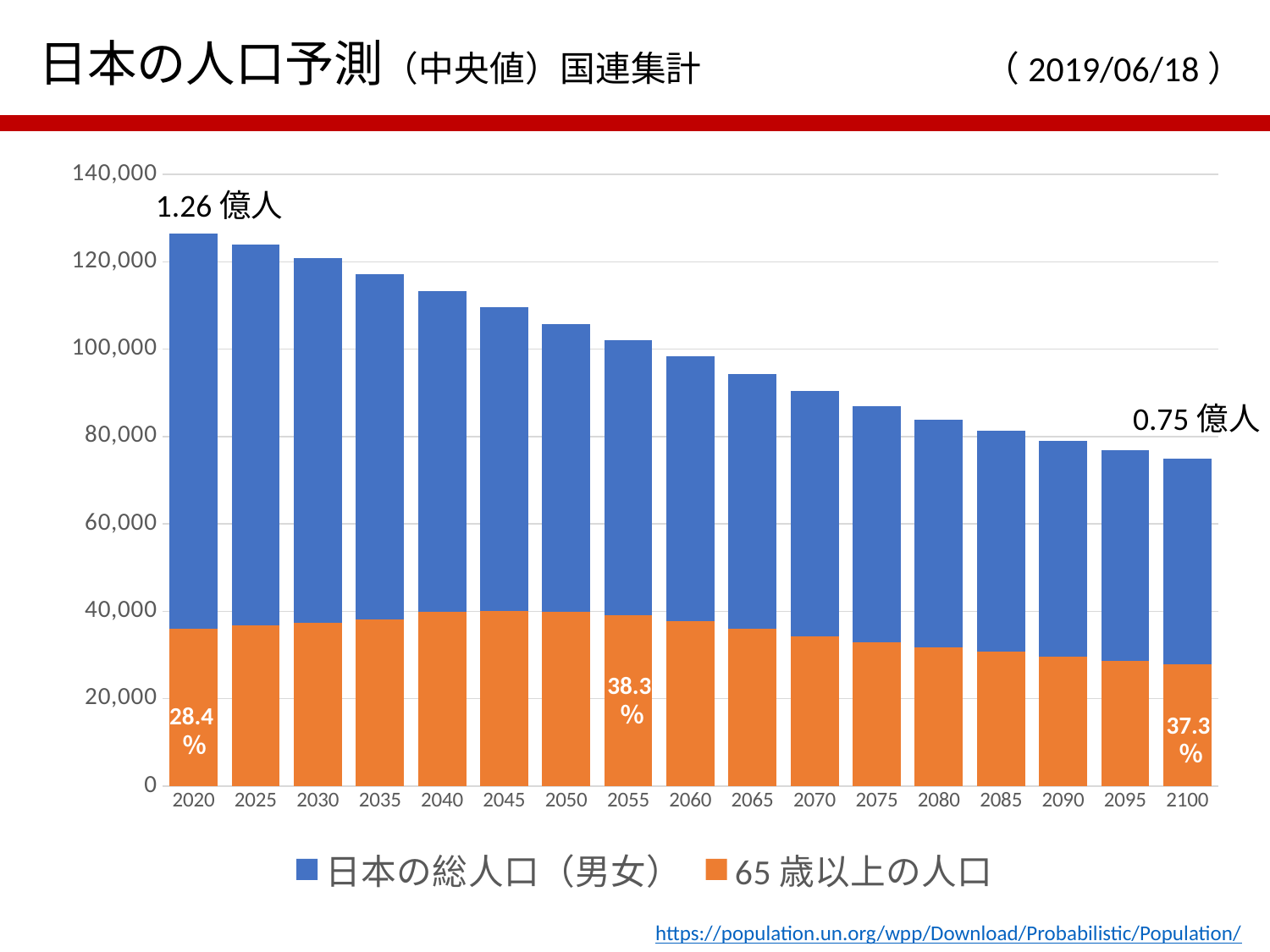
What are the two series named in the legend? 日本の総人口（男女） and 65歳以上の人口 What percentage is printed on the 65歳以上の人口 bar for 2100? 37.3% What percentage is printed on the 65歳以上の人口 bar for 2020? 28.4% What percentage is printed on the 65歳以上の人口 bar for 2055? 38.3% What kind of chart is shown on the slide? bar chart How many years (categories) are shown along the x axis? 17 What total population value is labelled above the 2100 bar? 0.75 億人 Which year has the highest 日本の総人口（男女） value? 2020 How many series does the legend list? 2 Does the 日本の総人口（男女） series rise or fall from 2020 to 2100? fall Is the 日本の総人口（男女） value for 2070 greater or less than 100,000? less What total population value is labelled above the 2020 bar? 1.26 億人